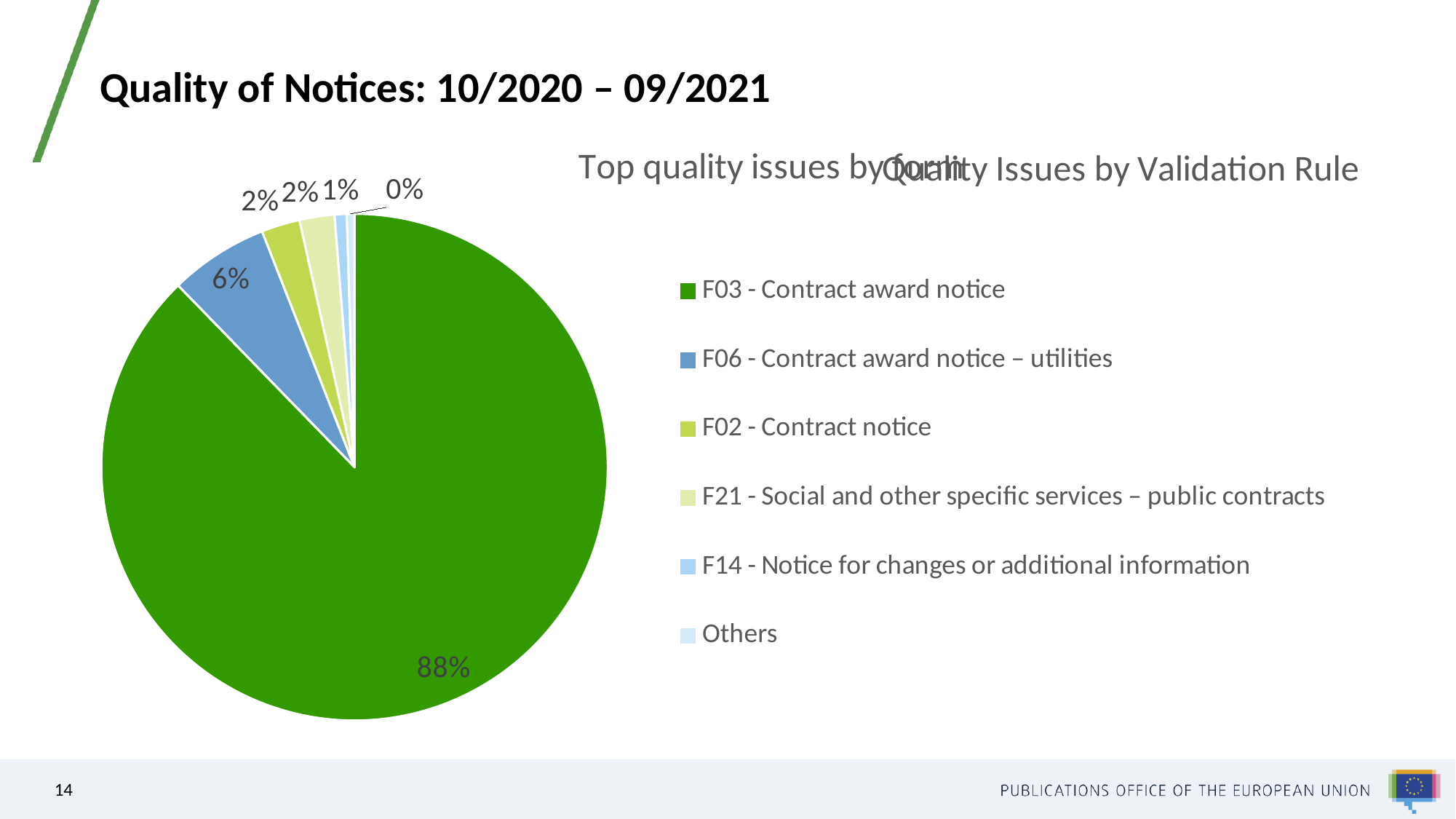
What type of chart is shown on the slide? Pie chart How many slices does the pie chart have? 6 Which is larger, the slice for F06 - Contract award notice – utilities or the slice for F02 - Contract notice? F06 - Contract award notice – utilities What colour is the slice for F03 - Contract award notice? Green What percentage is shown for F06 - Contract award notice – utilities? 6% Which category has the largest slice of the pie? F03 - Contract award notice What is the difference in percentage points between F03 - Contract award notice and F06 - Contract award notice – utilities? 82 percentage points What percentage is shown for F14 - Notice for changes or additional information? 1% What percentage is shown for the Others slice? 0% What percentage of the pie does F03 - Contract award notice account for? 88% What percentage is shown for F02 - Contract notice? 2% Which category has the smallest slice of the pie? Others